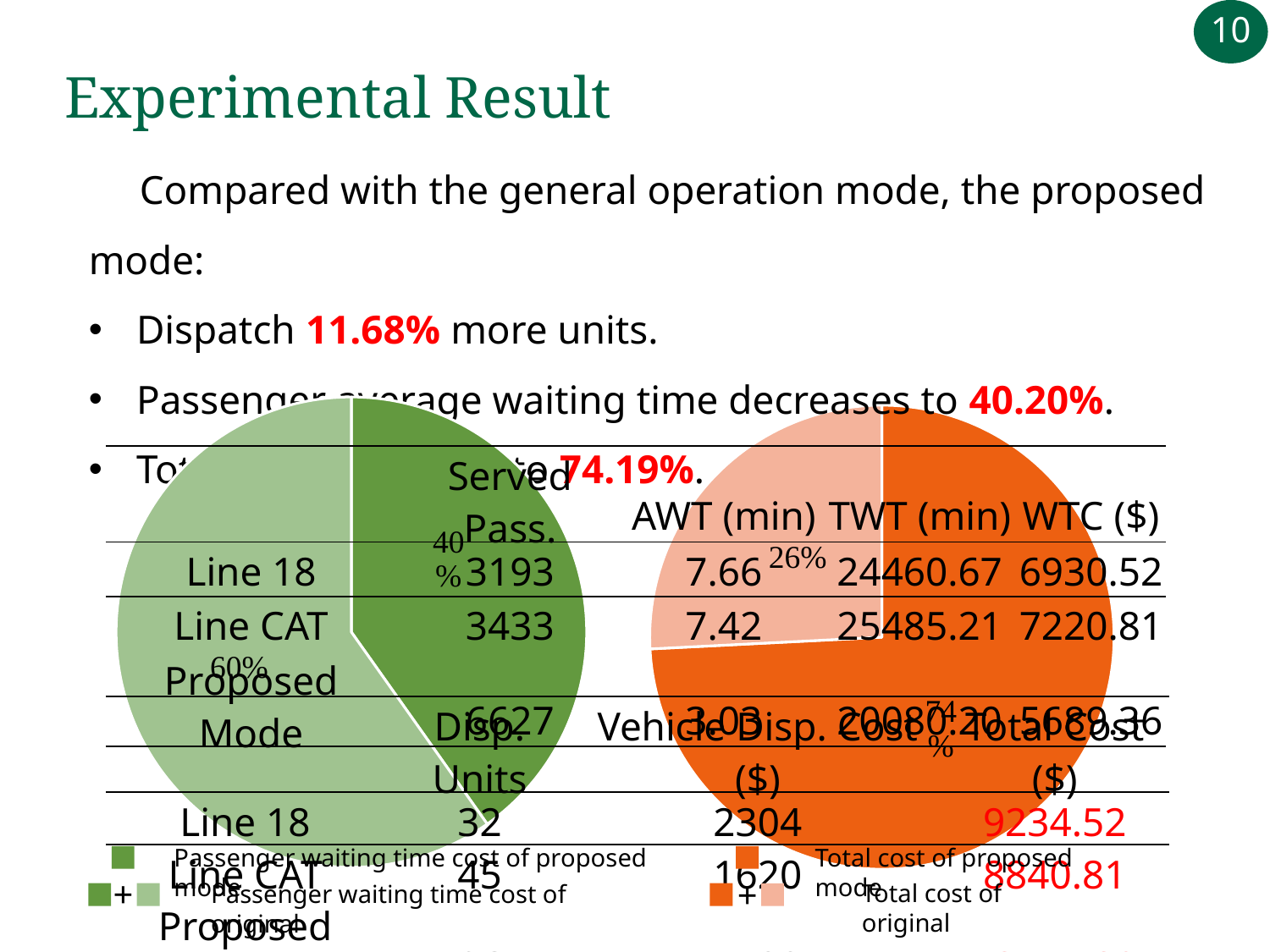
How many slices does the right pie chart have? 2 In the left pie chart, what is the difference in percentage points between the two slices? 20 In the left pie chart, what percentage is shown for the smaller slice? 40% In the left pie chart, what share is labelled for 'Passenger waiting time cost of proposed mode'? 40% In the right pie chart, what percentage is shown for the smaller slice? 26% How many entries does the legend of the left pie chart list? 2 In the right pie chart, which slice is larger: 'Total cost of proposed mode' or 'Total cost of original'? Total cost of proposed mode What type of chart is the left chart on the slide? Pie chart In the right pie chart, what is the difference in percentage points between the two slices? 48 In the right pie chart, what percentage is shown for the larger slice? 74% In the right pie chart, what share is labelled for 'Total cost of proposed mode'? 74%